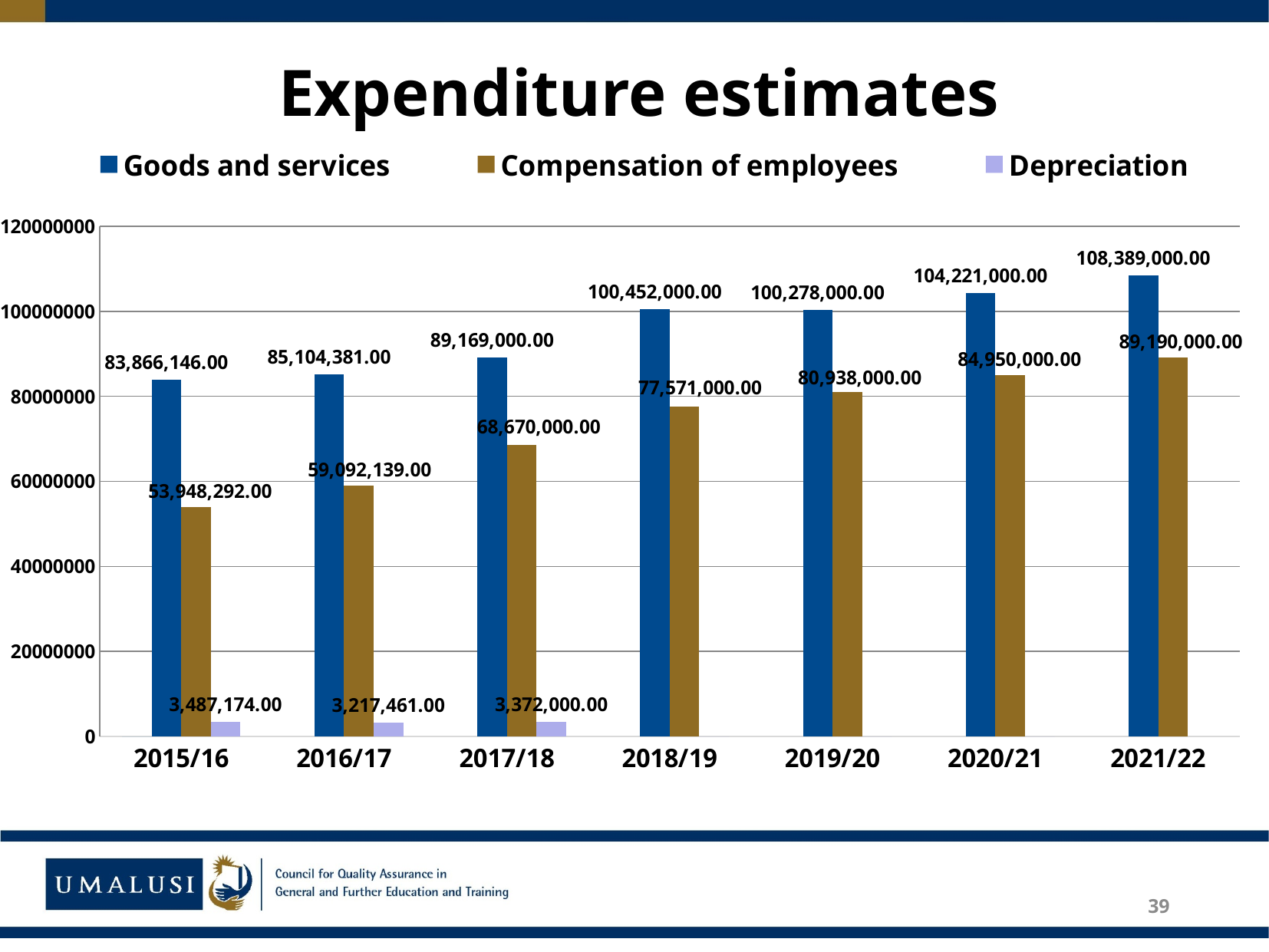
What is the difference between Goods and services in 2021/22 and 2020/21? 4,168,000.00 In which year is Goods and services highest? 2021/22 What is the value for Depreciation in 2016/17? 3,217,461.00 How many series does the legend list? 3 What is the difference between Compensation of employees in 2016/17 and 2015/16? 5,143,847.00 What kind of chart is this? Bar chart What is the value for Goods and services in 2018/19? 100,452,000.00 How many years are shown on the x axis? 7 What is the value for Compensation of employees in 2020/21? 84,950,000.00 Which year has the larger Goods and services value, 2018/19 or 2019/20? 2018/19 In which year is Compensation of employees lowest? 2015/16 In which year is Depreciation highest? 2015/16